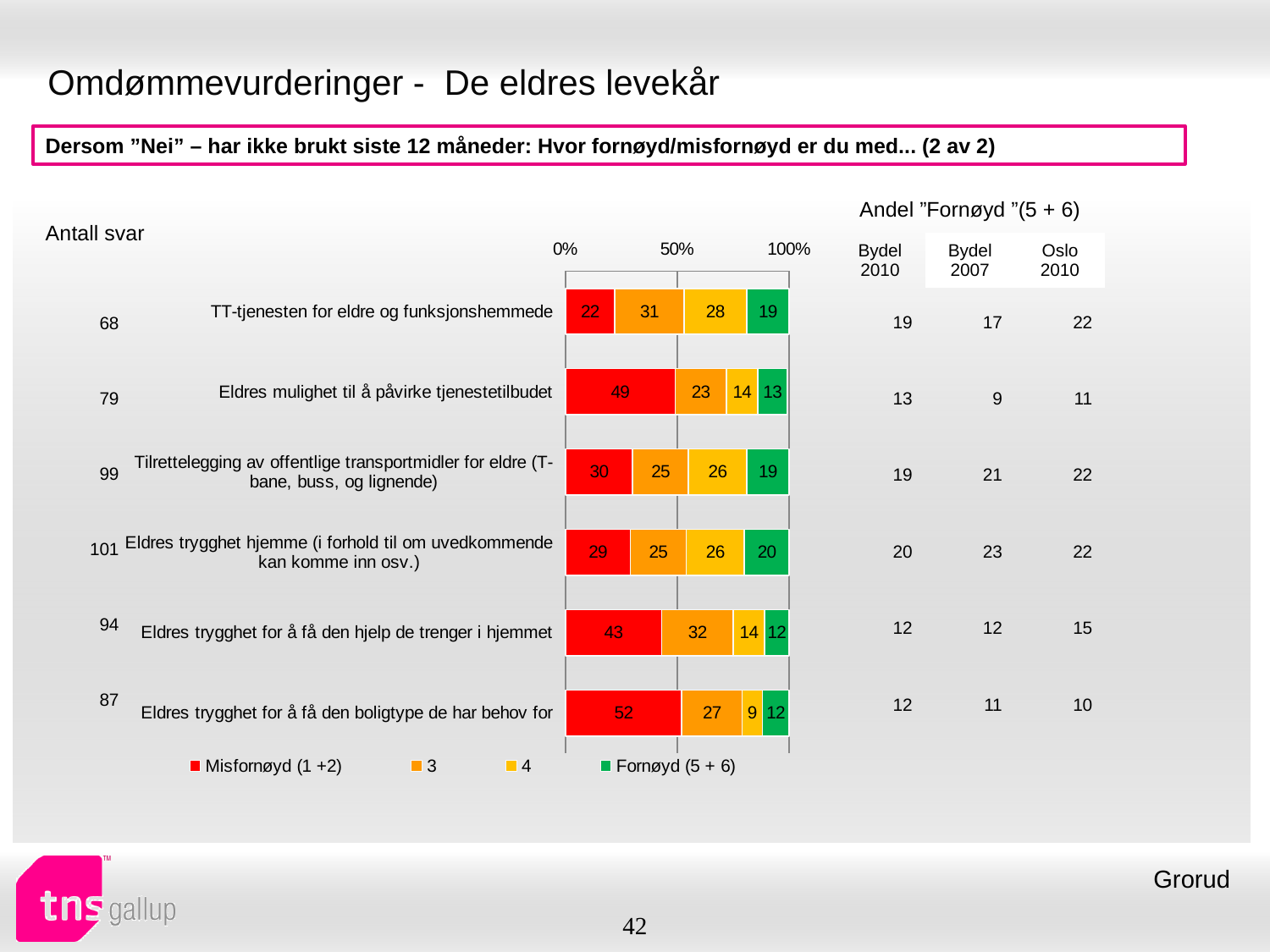
What kind of chart is shown on the slide? bar chart Which is larger: the Fornøyd (5 + 6) value for 'TT-tjenesten for eldre og funksjonshemmede' or for 'Eldres mulighet til å påvirke tjenestetilbudet'? TT-tjenesten for eldre og funksjonshemmede What is the total of the stacked bar for 'Eldres trygghet for å få den hjelp de trenger i hjemmet'? 101 Which category has the lowest Misfornøyd (1 +2) value? TT-tjenesten for eldre og funksjonshemmede How many categories (rows) does the chart show? 6 What is the Fornøyd (5 + 6) value for 'Eldres trygghet hjemme (i forhold til om uvedkommende kan komme inn osv.)'? 20 What colour represents the Fornøyd (5 + 6) series in the chart? green What is the Misfornøyd (1 +2) value for 'Eldres trygghet for å få den boligtype de har behov for'? 52 How many series does the legend list? 4 What is the value of series '3' for 'TT-tjenesten for eldre og funksjonshemmede'? 31 What is the difference between the Misfornøyd (1 +2) values for 'Eldres mulighet til å påvirke tjenestetilbudet' and 'Tilrettelegging av offentlige transportmidler for eldre (T-bane, buss, og lignende)'? 19 Which category has the highest Misfornøyd (1 +2) value? Eldres trygghet for å få den boligtype de har behov for